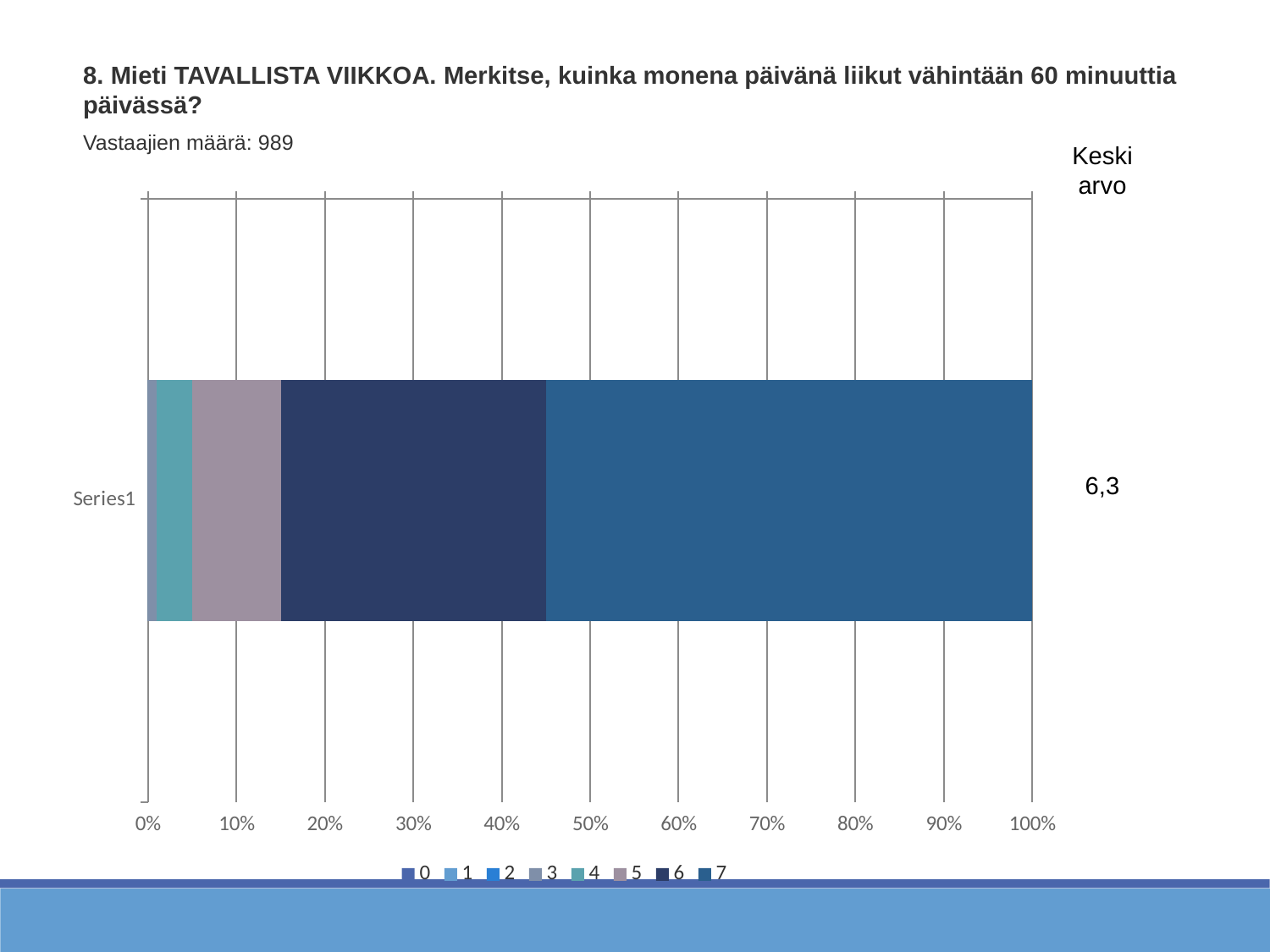
How many series does the legend list? 8 How many categories are plotted on the vertical axis? 1 Which takes up a larger share of the Series1 bar, series 5 or series 6? 6 Which legend series occupies the largest share of the Series1 bar? 7 What kind of chart is shown on the slide? stacked bar chart Which takes up a larger share of the Series1 bar, series 6 or series 7? 7 Is the share of series 5 in the Series1 bar greater or less than 20%? less Is the share of series 7 in the Series1 bar greater or less than 50%? greater Is the share of series 4 in the Series1 bar greater or less than 10%? less What mean value (Keskiarvo) is shown to the right of the chart? 6,3 What is the number of respondents (Vastaajien määrä) shown above the chart? 989